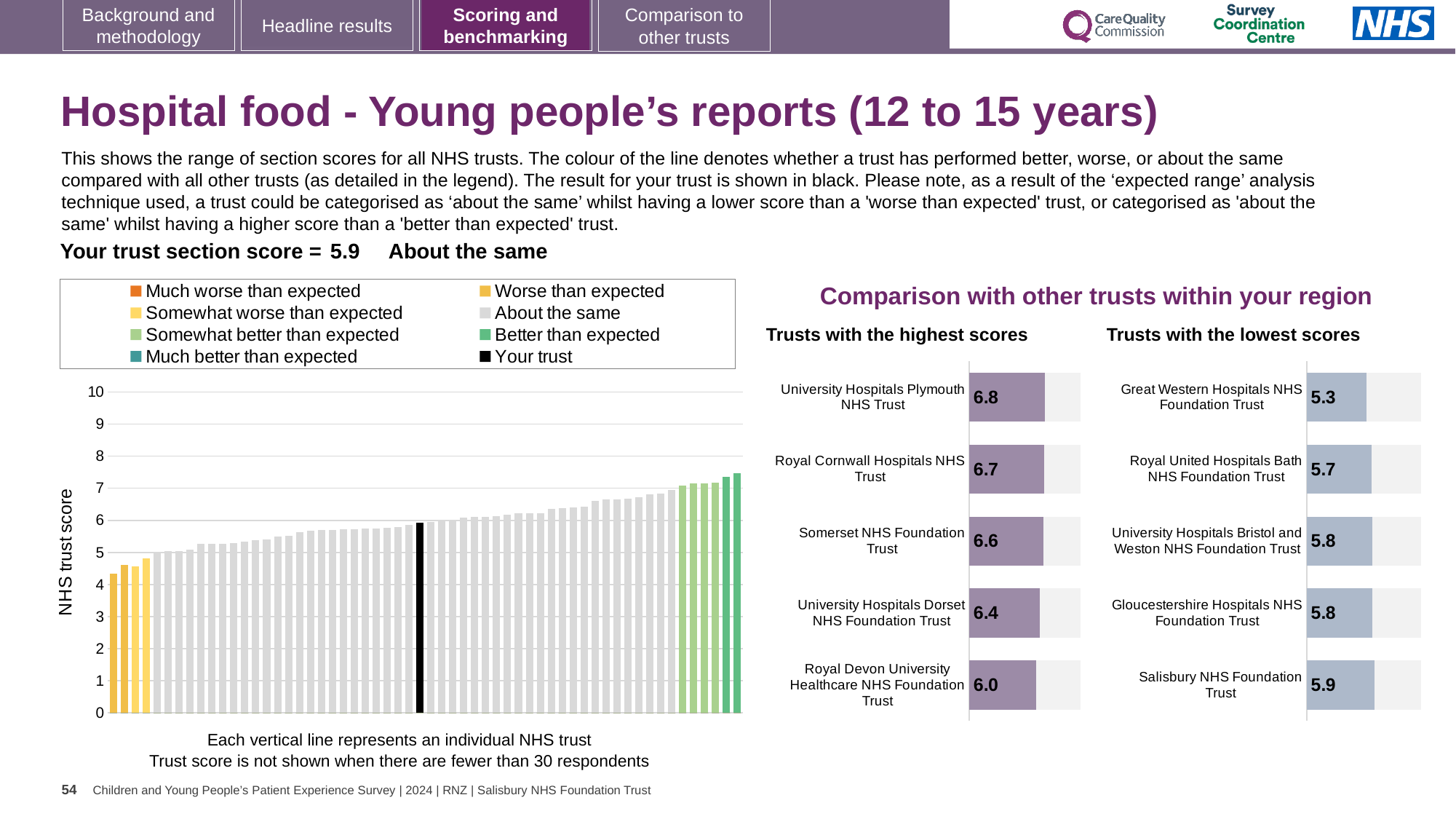
In the 'Trusts with the highest scores' chart, what is the score for University Hospitals Plymouth NHS Trust? 6.8 How many trusts are shown in the 'Trusts with the lowest scores' chart? 5 In the 'Trusts with the highest scores' chart, which trust has the lowest score? Royal Devon University Healthcare NHS Foundation Trust In the 'Trusts with the lowest scores' chart, which has the higher score: Royal United Hospitals Bath NHS Foundation Trust or Great Western Hospitals NHS Foundation Trust? Royal United Hospitals Bath NHS Foundation Trust In the 'Trusts with the highest scores' chart, what is the difference between the scores of University Hospitals Plymouth NHS Trust and Royal Devon University Healthcare NHS Foundation Trust? 0.8 In the 'Trusts with the lowest scores' chart, which trust has the lowest score? Great Western Hospitals NHS Foundation Trust In the 'Trusts with the highest scores' chart, what is the score for Somerset NHS Foundation Trust? 6.6 In the main 'NHS trust score' chart, is the value of the tallest bar greater or less than 7? greater In the 'Trusts with the lowest scores' chart, what is the score for Salisbury NHS Foundation Trust? 5.9 What kind of chart is the main chart on the left showing NHS trust scores? Bar chart In the 'Trusts with the lowest scores' chart, what is the score for Great Western Hospitals NHS Foundation Trust? 5.3 How many entries does the legend of the main 'NHS trust score' chart list? 8